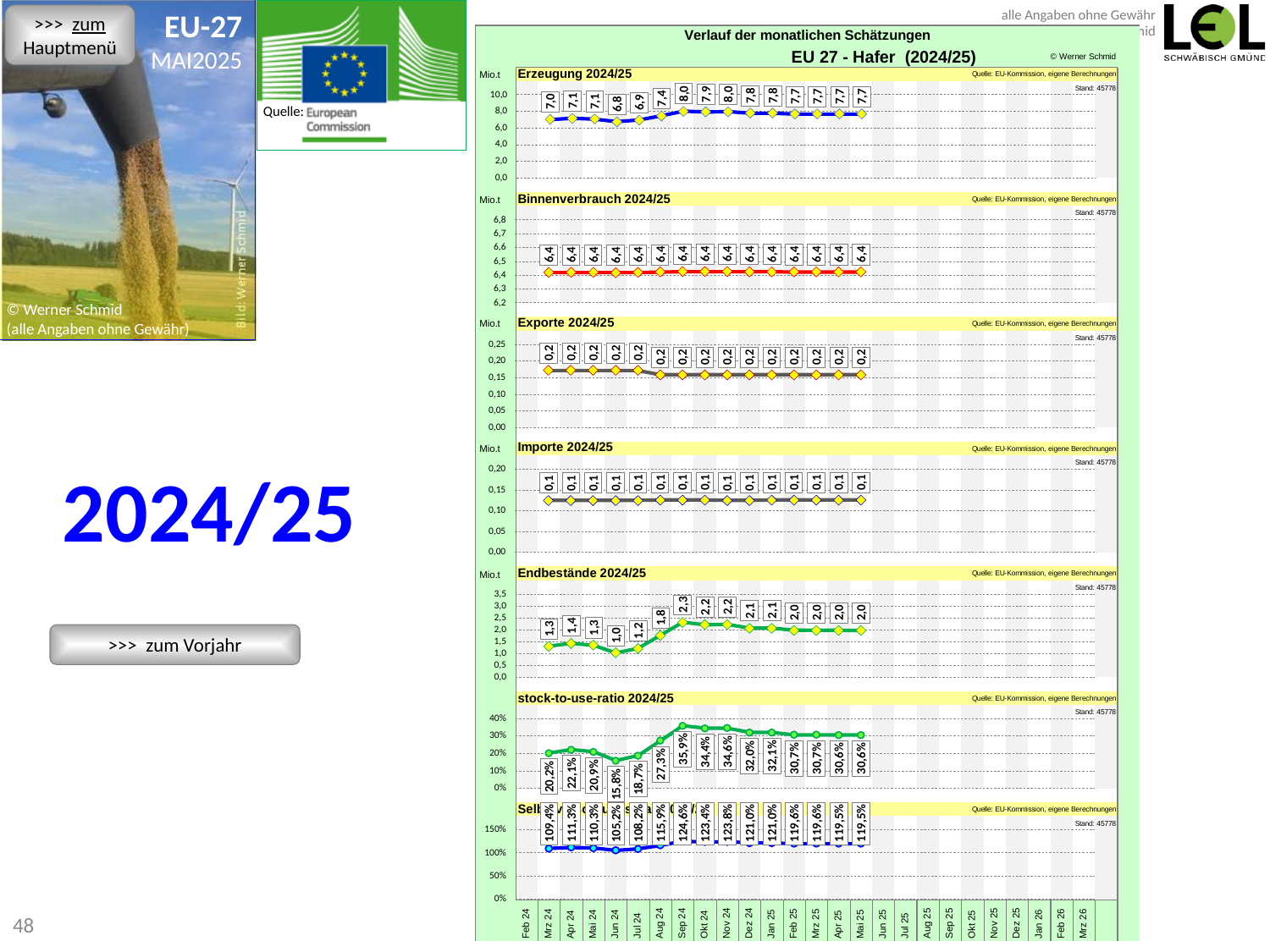
In the Endbestände 2024/25 chart, what is the difference between the highest value (2,3) and the lowest value (1,0)? 1,3 In the Endbestände 2024/25 chart, what is the lowest value shown? 1,0 What type of chart is used for Erzeugung 2024/25? line chart In the Importe 2024/25 chart, what value is shown for every month? 0,1 In the Binnenverbrauch 2024/25 chart, what value is shown for every month? 6,4 In the Exporte 2024/25 chart, what value is shown for every month? 0,2 In the Erzeugung 2024/25 chart, what is the highest value shown? 8,0 In the Endbestände 2024/25 chart, what is the highest value shown? 2,3 In the Erzeugung 2024/25 chart, what is the last (most recent) value plotted? 7,7 In the Erzeugung 2024/25 chart, what is the lowest value shown? 6,8 In the stock-to-use-ratio 2024/25 chart, what is the highest value shown? 35,9% In the stock-to-use-ratio 2024/25 chart, what is the lowest value shown? 15,8%